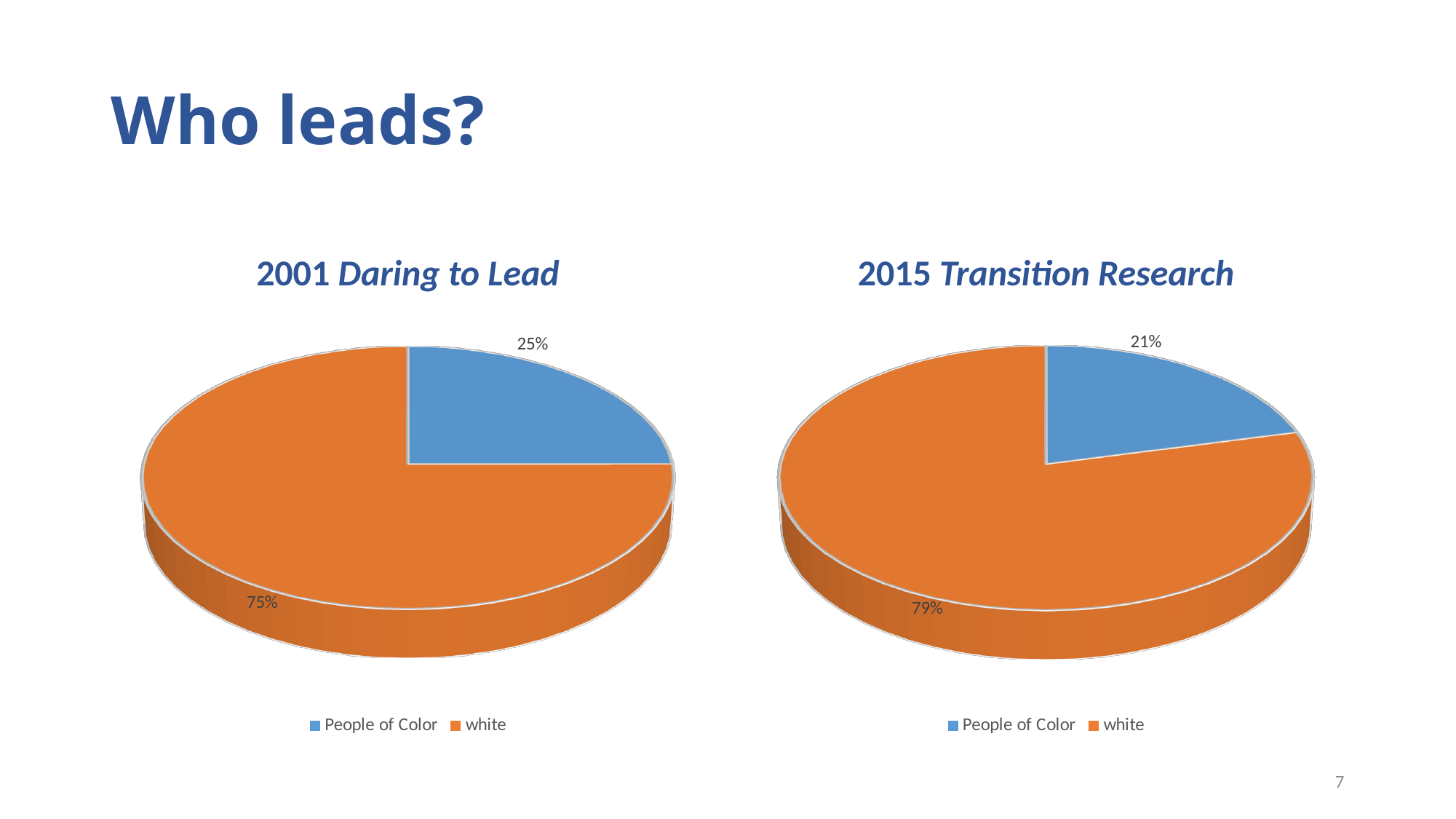
In the 2015 Transition Research chart, which slice is the smallest? People of Color In the 2001 Daring to Lead chart, which slice is the largest? white In the 2015 Transition Research chart, what share of the pie is white? 79% In the 2015 Transition Research chart, what colour is the People of Color slice? Blue In the 2015 Transition Research chart, what is the difference between the white and People of Color shares? 58% In the 2001 Daring to Lead chart, what is the difference between the white and People of Color shares? 50% Is the People of Color share larger in the 2001 Daring to Lead chart or the 2015 Transition Research chart? 2001 Daring to Lead In the 2015 Transition Research chart, what share of the pie is People of Color? 21% In the 2001 Daring to Lead chart, what share of the pie is white? 75% What kind of chart is the 2015 Transition Research chart? Pie chart In the 2001 Daring to Lead chart, what share of the pie is People of Color? 25% How many slices does the 2001 Daring to Lead pie chart have? 2